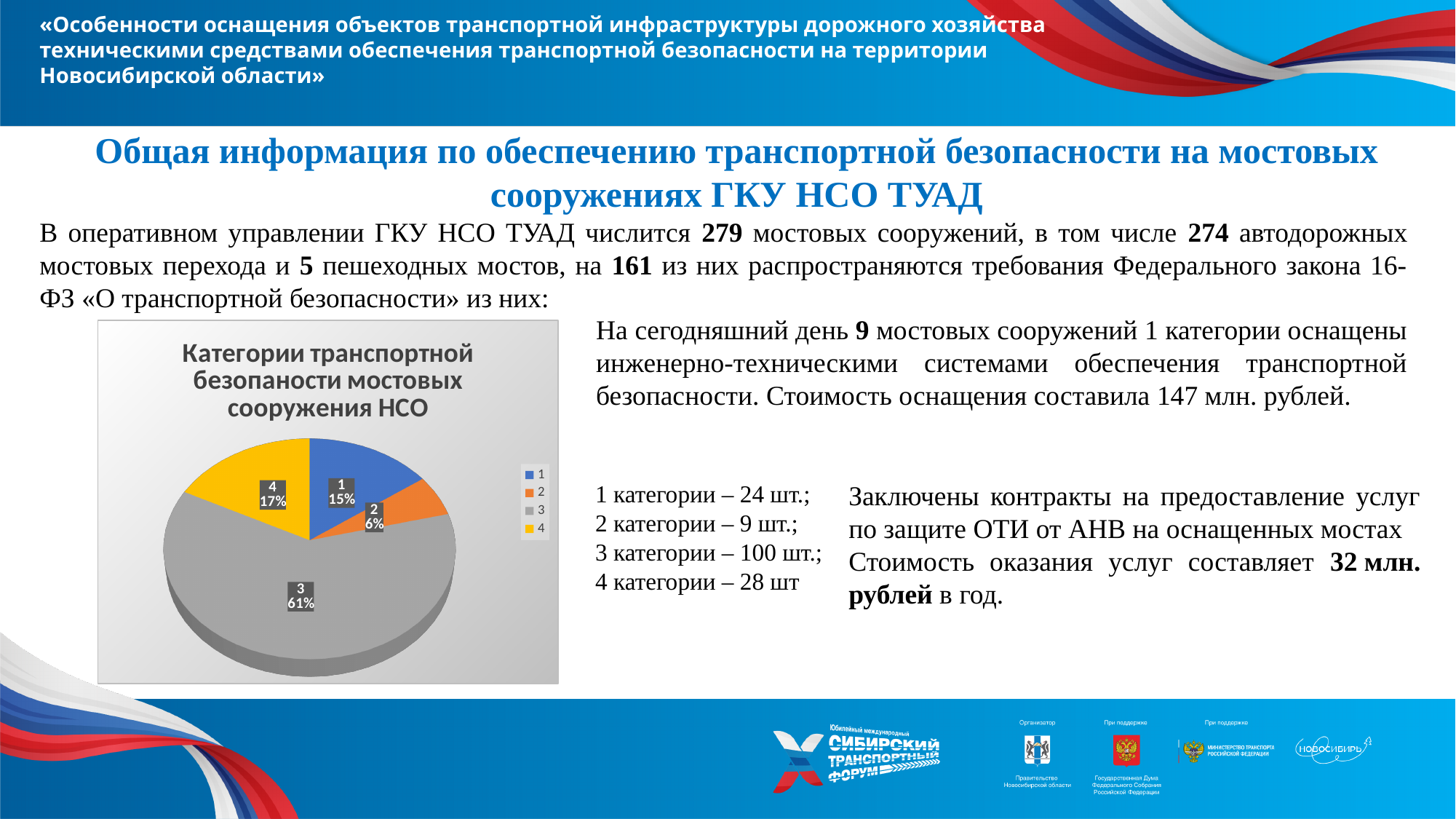
Which category has the smallest slice of the pie? 2 What is the value shown for category 2 in the pie chart? 6% Which has a larger share, category 1 or category 4? 4 What share of the pie does category 3 represent? 61% What is the value shown for category 1 in the pie chart? 15% What is the difference between the shares of category 4 and category 2? 11% What kind of chart is shown on the slide? pie chart What is the value shown for category 4 in the pie chart? 17% Which category has the largest slice of the pie? 3 What is the difference between the shares of category 3 and category 1? 46% What colour is the slice for category 3? grey How many slices does the pie chart have? 4